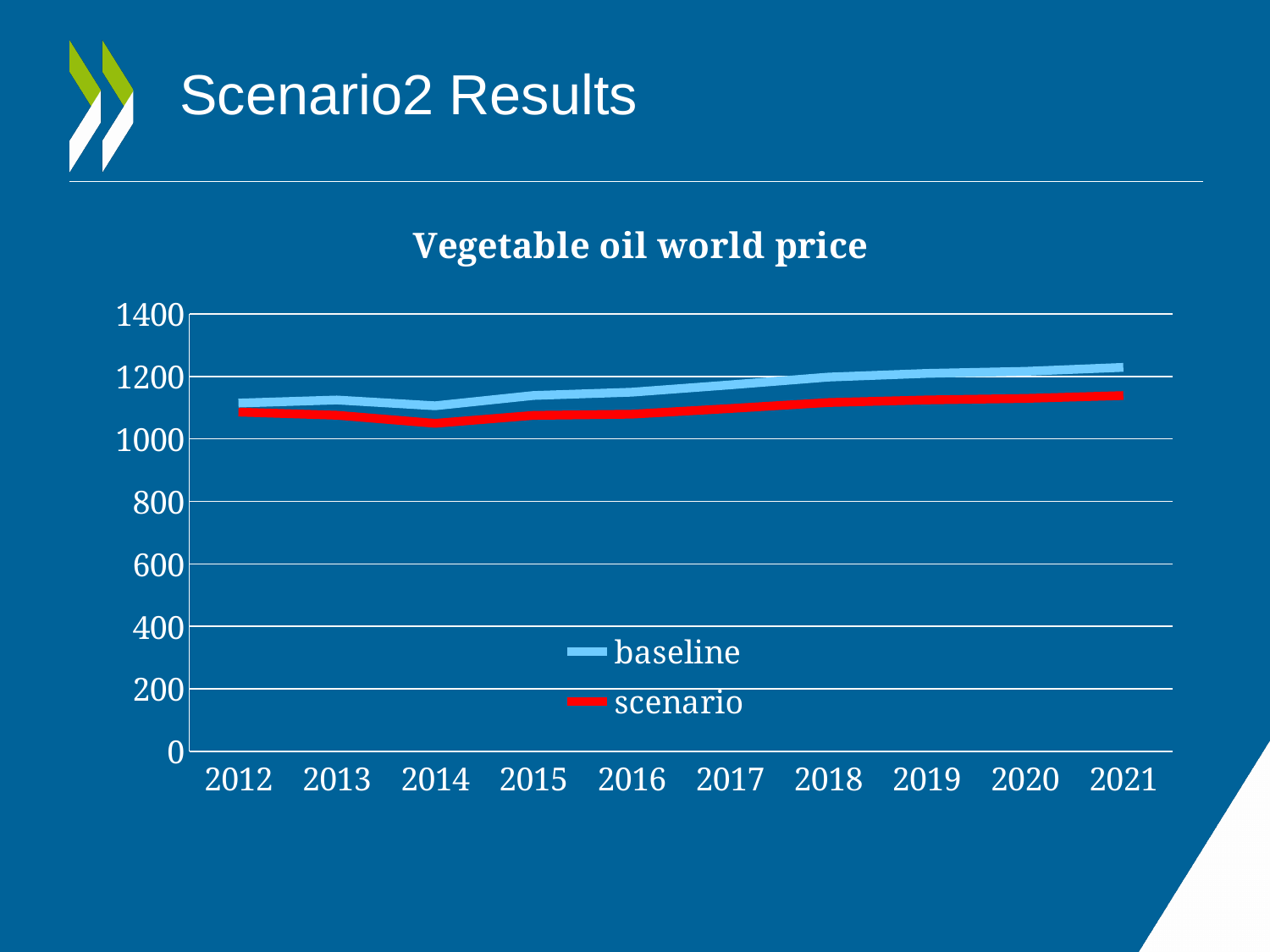
Which series is drawn in red? scenario Does the baseline series rise or fall from 2014 to 2021? rise How many years are shown on the x axis? 10 In which year does the scenario series reach its lowest value? 2014 In 2021, which series has the higher value, baseline or scenario? baseline In which year does the baseline series reach its highest value? 2021 What kind of chart is shown on the slide? line chart What is the title of the chart? Vegetable oil world price Is the scenario value for 2014 greater or less than 1200? less Is the baseline value for 2021 greater or less than 1200? greater Is the scenario value for 2012 greater or less than 1000? greater How many series does the legend list? 2